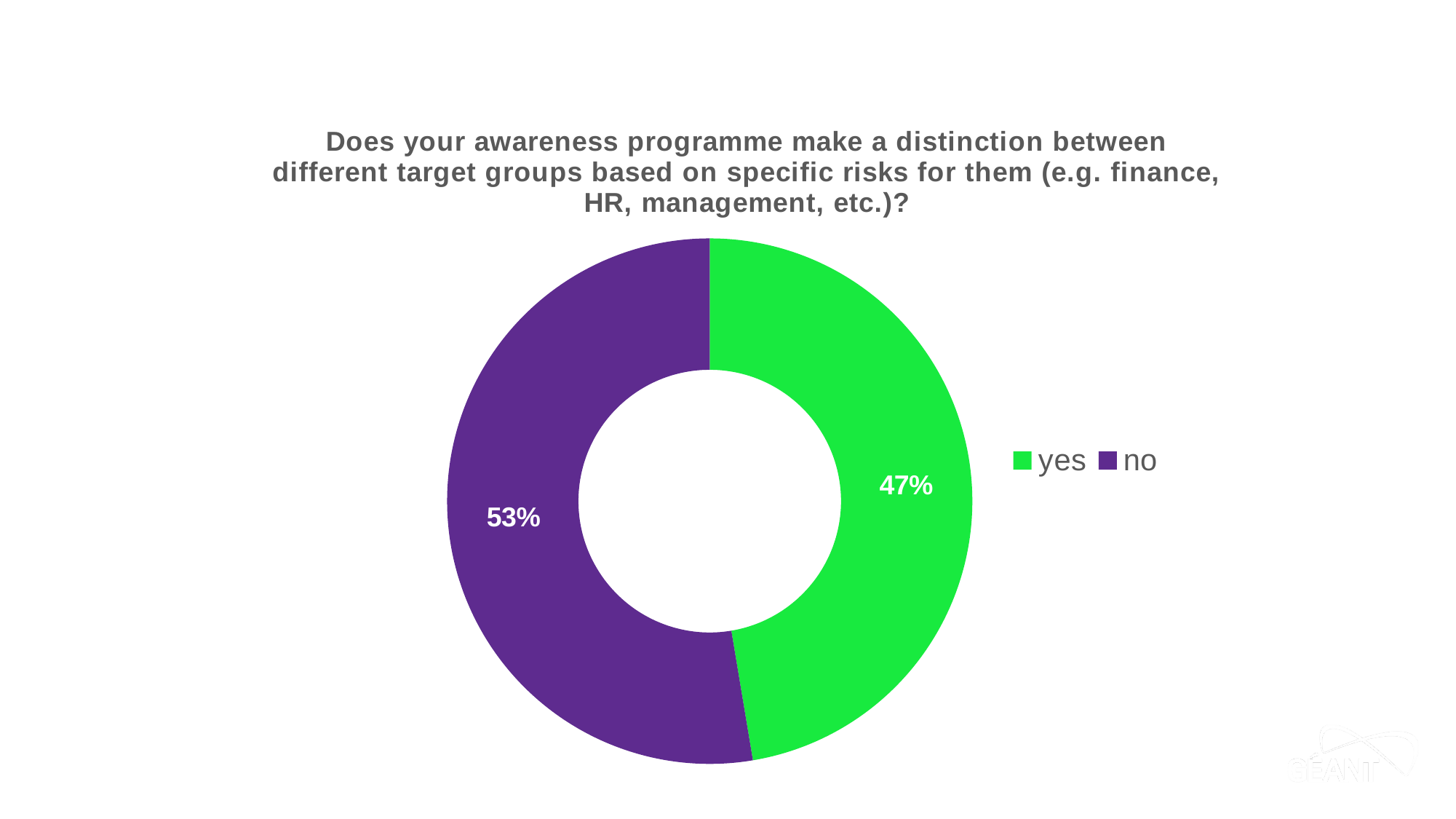
What percentage of respondents answered "no"? 53% Which response has the smallest share of the chart? yes What kind of chart is shown on the slide? Pie chart (doughnut) Which response has the largest share of the chart? no Which response has the larger share, "yes" or "no"? no What share of the chart does the "no" slice represent? 53% Which colour represents the "yes" response in the chart? Green What percentage of respondents answered "yes"? 47% Is the share for "yes" greater or less than 50%? less How many response categories are shown in the chart? 2 What is the difference in percentage points between the "no" and "yes" shares? 6 How many entries does the legend list? 2